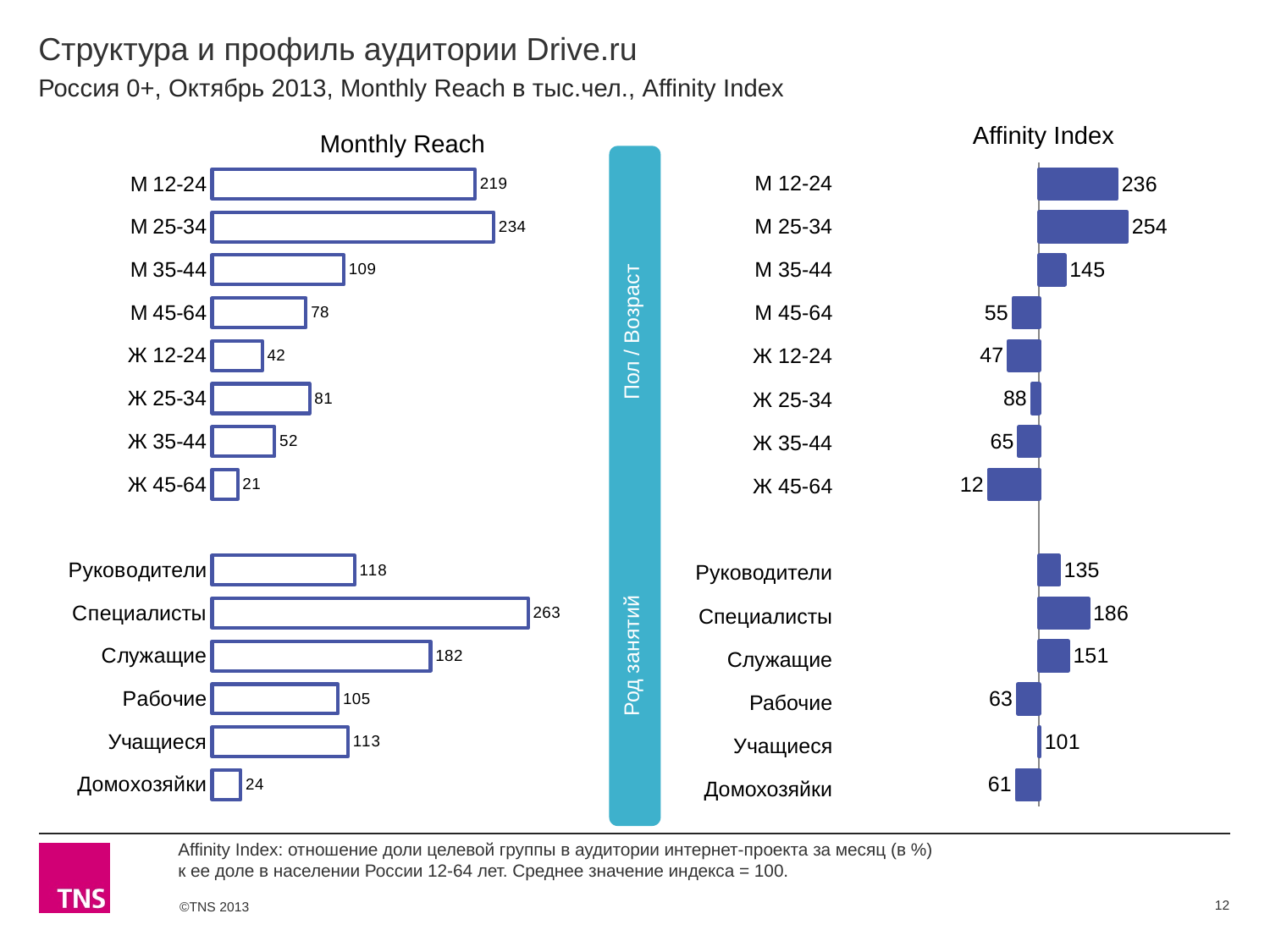
In the Affinity Index chart, which category has the highest value? М 25-34 How many categories are shown in the Monthly Reach chart? 14 In the Monthly Reach chart, what is the difference between the values for М 12-24 and М 35-44? 110 In the Affinity Index chart, which category has the lowest value? Ж 45-64 In the Monthly Reach chart, which category has the highest value? Специалисты In the Monthly Reach chart, what is the value for М 25-34? 234 In the Affinity Index chart, what is the difference between the values for М 25-34 and М 12-24? 18 What type of chart is the Affinity Index chart? Bar chart In the Affinity Index chart, which is larger: the value for Руководители or the value for Служащие? Служащие In the Monthly Reach chart, what is the value for Домохозяйки? 24 In the Monthly Reach chart, which is larger: the value for Рабочие or the value for Учащиеся? Учащиеся In the Affinity Index chart, what is the value for Специалисты? 186